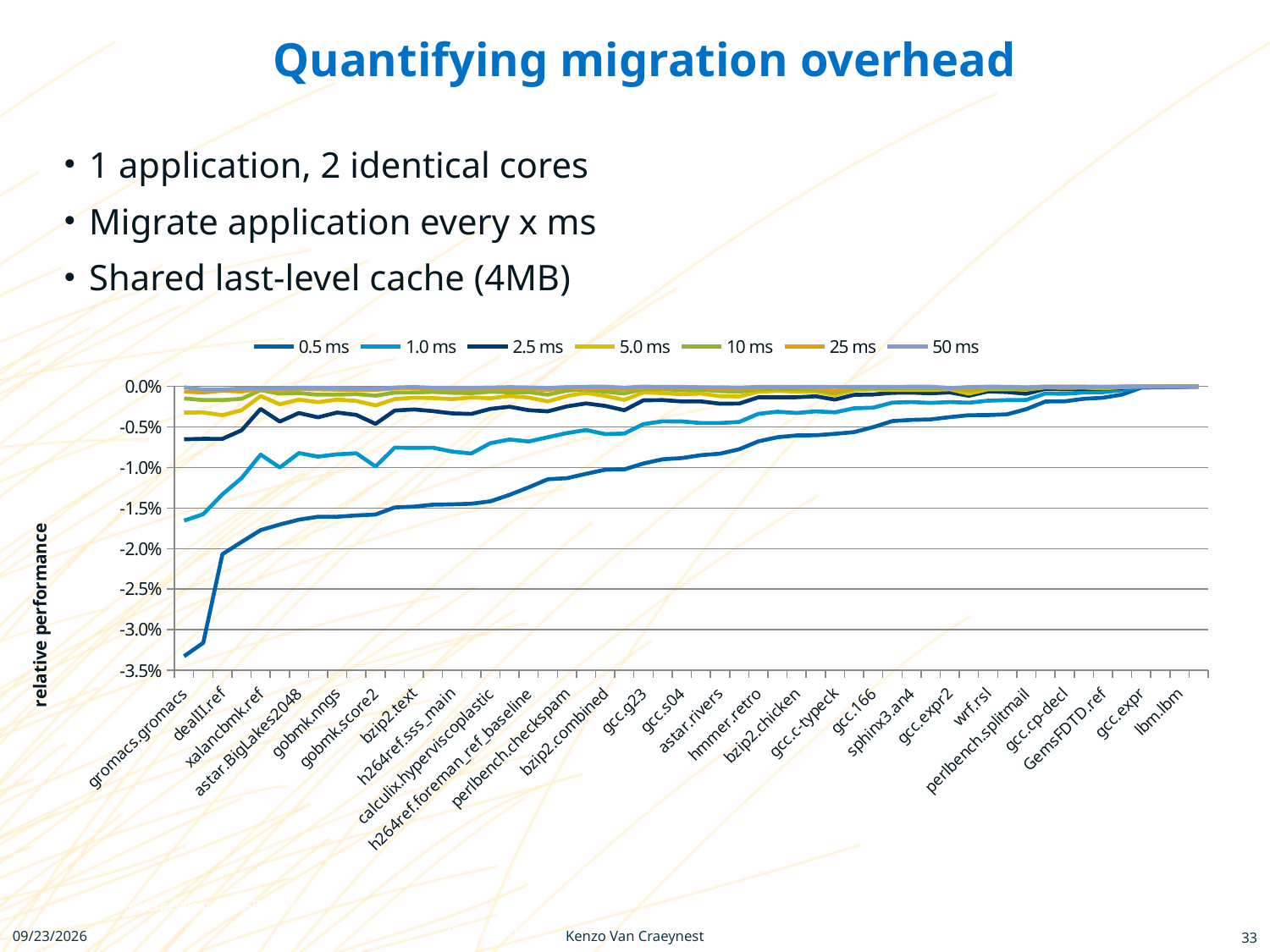
At gromacs.gromacs, which is larger: the 0.5 ms value or the 1.0 ms value? 1.0 ms Which series has the lowest value at gromacs.gromacs? 0.5 ms Is the 0.5 ms value for gromacs.gromacs greater or less than -3.0%? less How many series does the chart's legend list? 7 What is the label on the vertical axis of the chart? relative performance Which series is listed first in the chart's legend? 0.5 ms Do the values of the 0.5 ms series rise or fall from left to right along the x axis? rise What kind of chart is shown on the slide? line chart Is the 1.0 ms value for gobmk.nngs greater or less than -1.0%? greater Is the 0.5 ms value for xalancbmk.ref greater or less than -1.5%? less Which series stays closest to 0.0% across all benchmarks? 50 ms